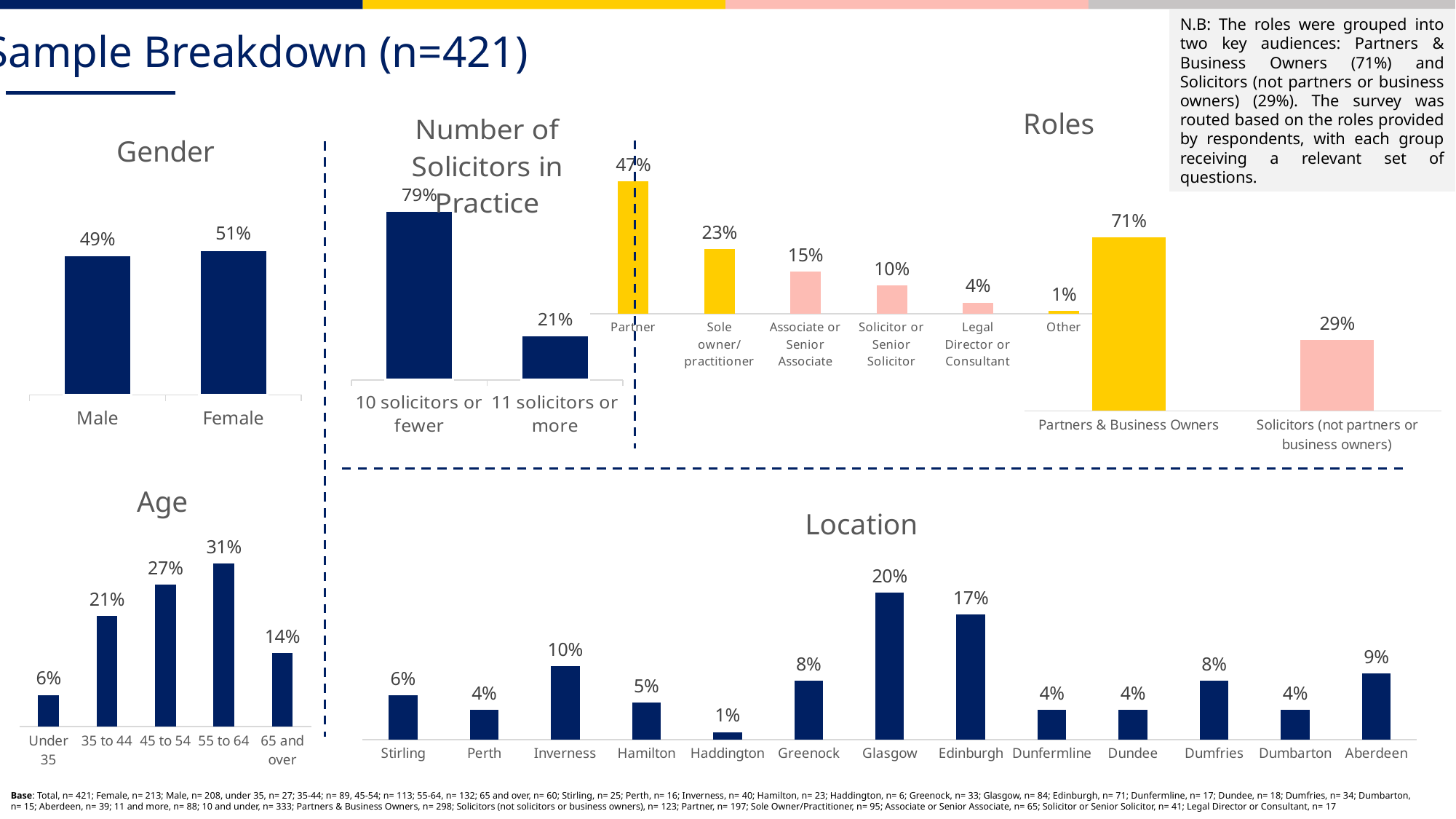
In the Number of Solicitors in Practice chart, what is the value for '10 solicitors or fewer'? 79% In the Gender chart, what percentage of the sample is Female? 51% In the Location chart, how many locations are shown? 13 In the Location chart, what is the difference between Inverness and Stirling? 4% In the Roles chart, what is the difference between Partners & Business Owners and Solicitors (not partners or business owners)? 42% In the Location chart, which is larger, Glasgow or Edinburgh? Glasgow In the Roles chart, what is the value for Legal Director or Consultant? 4% In the Roles chart, which role has the highest percentage? Partner In the Age chart, what is the value for 45 to 54? 27% In the Age chart, which age group has the highest percentage? 55 to 64 In the Location chart, which location has the lowest percentage? Haddington What type of chart is the Age chart? Bar chart